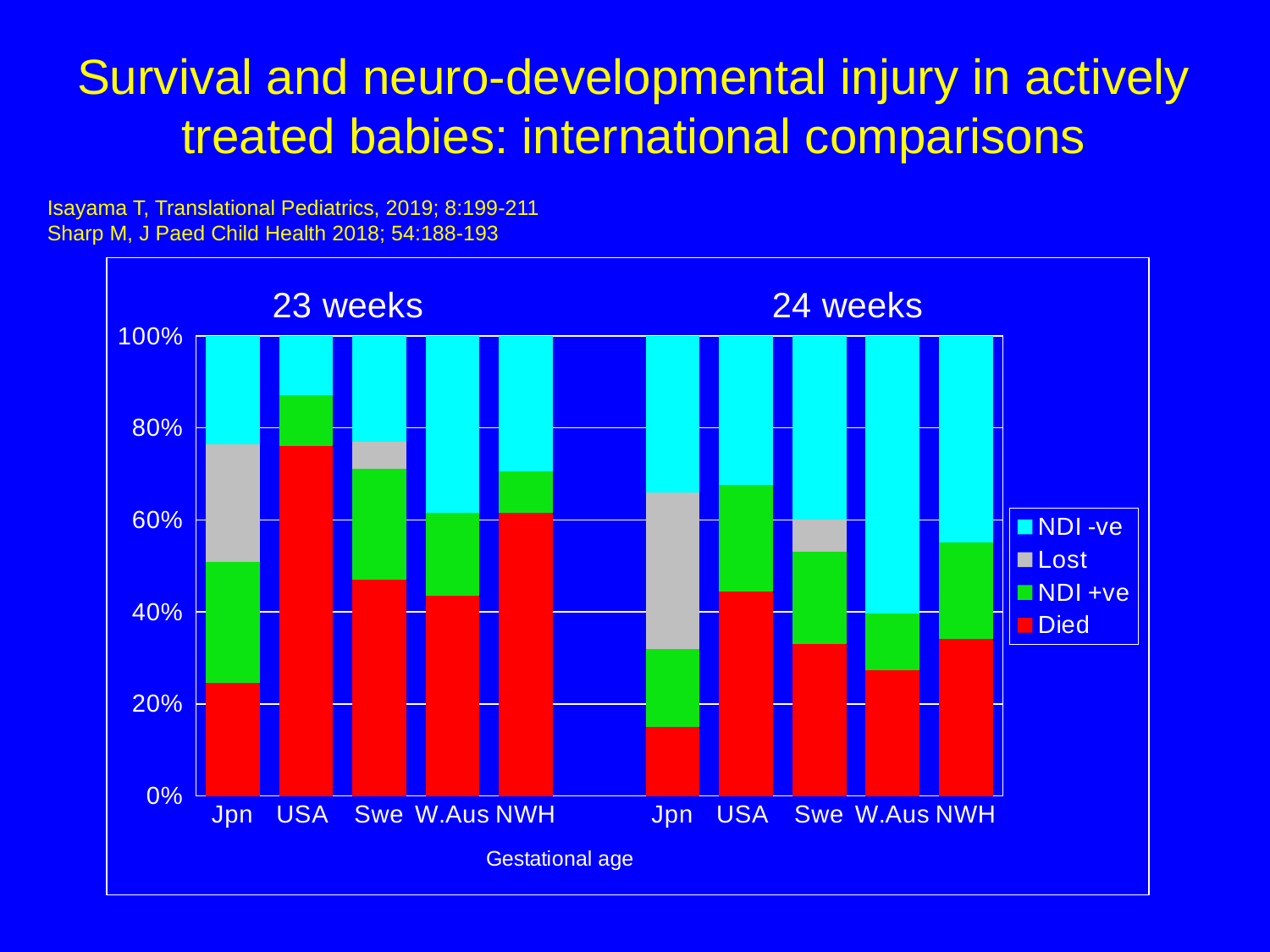
Is the Died share for USA at 23 weeks greater or less than 60%? greater What is the title of the x axis? Gestational age Which country has the lowest Died share in the 23 weeks group? Jpn Which country has the highest Died share in the 23 weeks group? USA How many bars are plotted in the chart in total? 10 What kind of chart is shown on the slide? Stacked bar chart Is the Died share for Jpn at 24 weeks greater or less than 20%? less Is the Died share for NWH at 23 weeks greater or less than 40%? greater Which country has the lowest Died share in the 24 weeks group? Jpn Which is larger, the Died share for USA at 23 weeks or the Died share for USA at 24 weeks? USA at 23 weeks How many series does the legend list? 4 Which country in the 24 weeks group has the largest Lost segment? Jpn